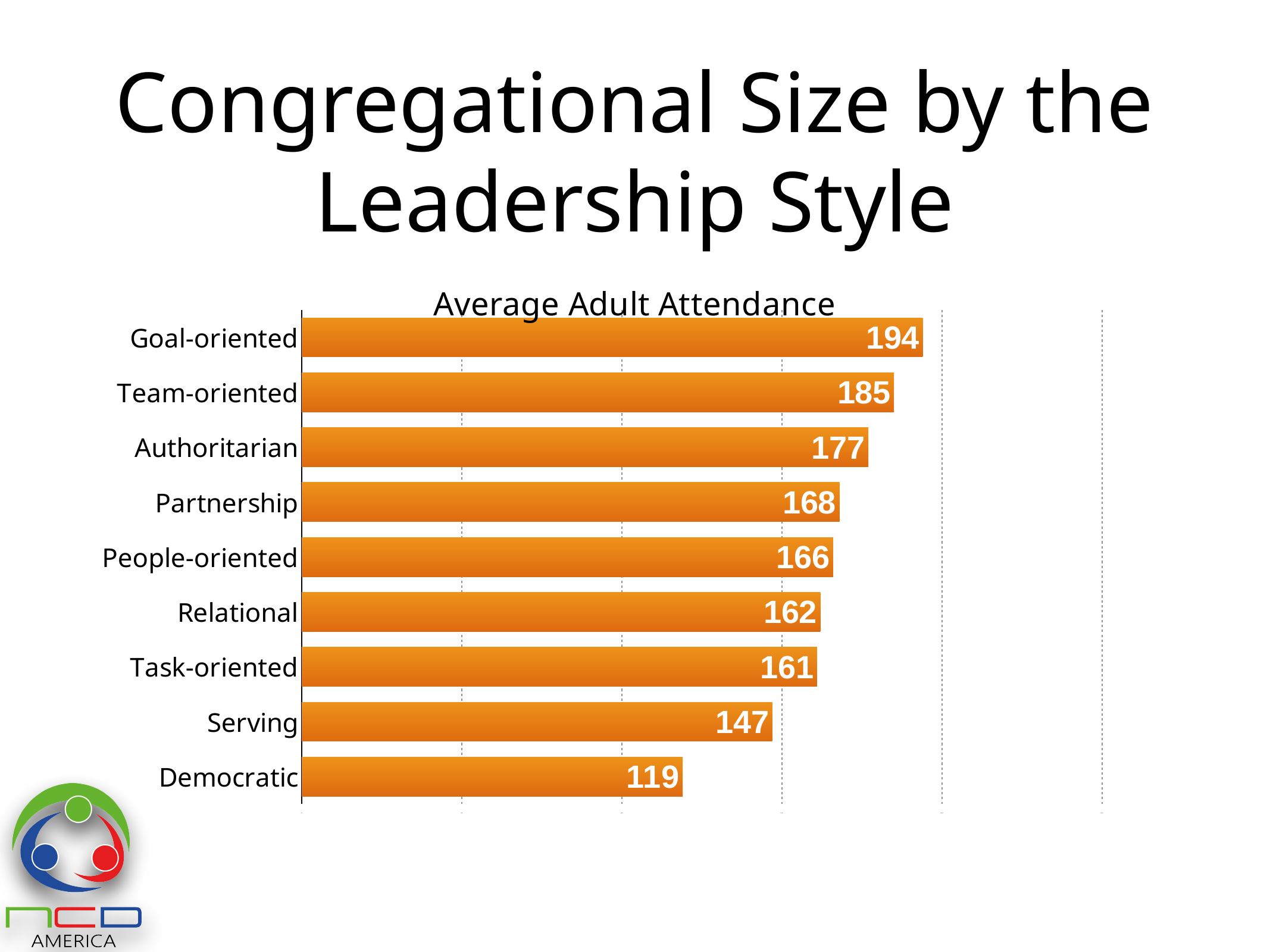
What is the title of the chart? Average Adult Attendance What is the average adult attendance for Serving leadership? 147 How many leadership styles are shown in the chart? 9 Which has a higher average adult attendance, Relational or Serving? Relational What is the difference in average adult attendance between Goal-oriented and Democratic leadership? 75 What is the difference in average adult attendance between Team-oriented and Authoritarian leadership? 8 Which leadership style has the highest average adult attendance? Goal-oriented What is the average adult attendance for Partnership leadership? 168 What is the average adult attendance for Democratic leadership? 119 What kind of chart is shown on the slide? Bar chart Which leadership style has the lowest average adult attendance? Democratic What is the average adult attendance for Goal-oriented leadership? 194